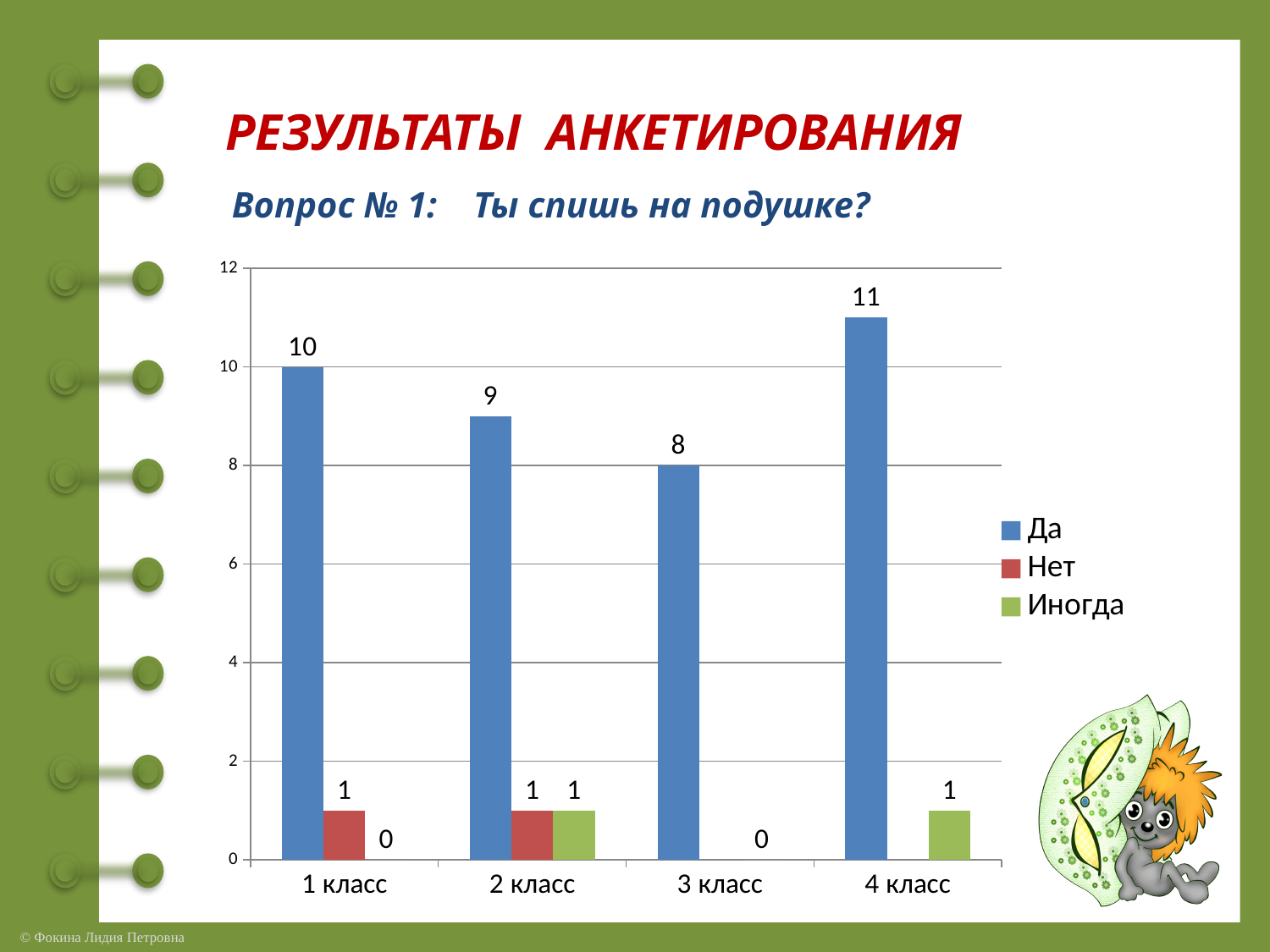
What is the value of "Иногда" for 4 класс? 1 What is the value of "Нет" for 2 класс? 1 What kind of chart is shown on the slide? bar chart Which is larger: the "Да" value for 2 класс or for 3 класс? 2 класс Which class has the highest value for "Да"? 4 класс What is the value of "Да" for 1 класс? 10 What is the difference between the "Да" values for 4 класс and 1 класс? 1 What question is the chart about, as stated above it? Ты спишь на подушке? What is the value of "Да" for 3 класс? 8 How many class categories are shown on the x axis? 4 Which class has the lowest value for "Да"? 3 класс How many series does the legend list? 3